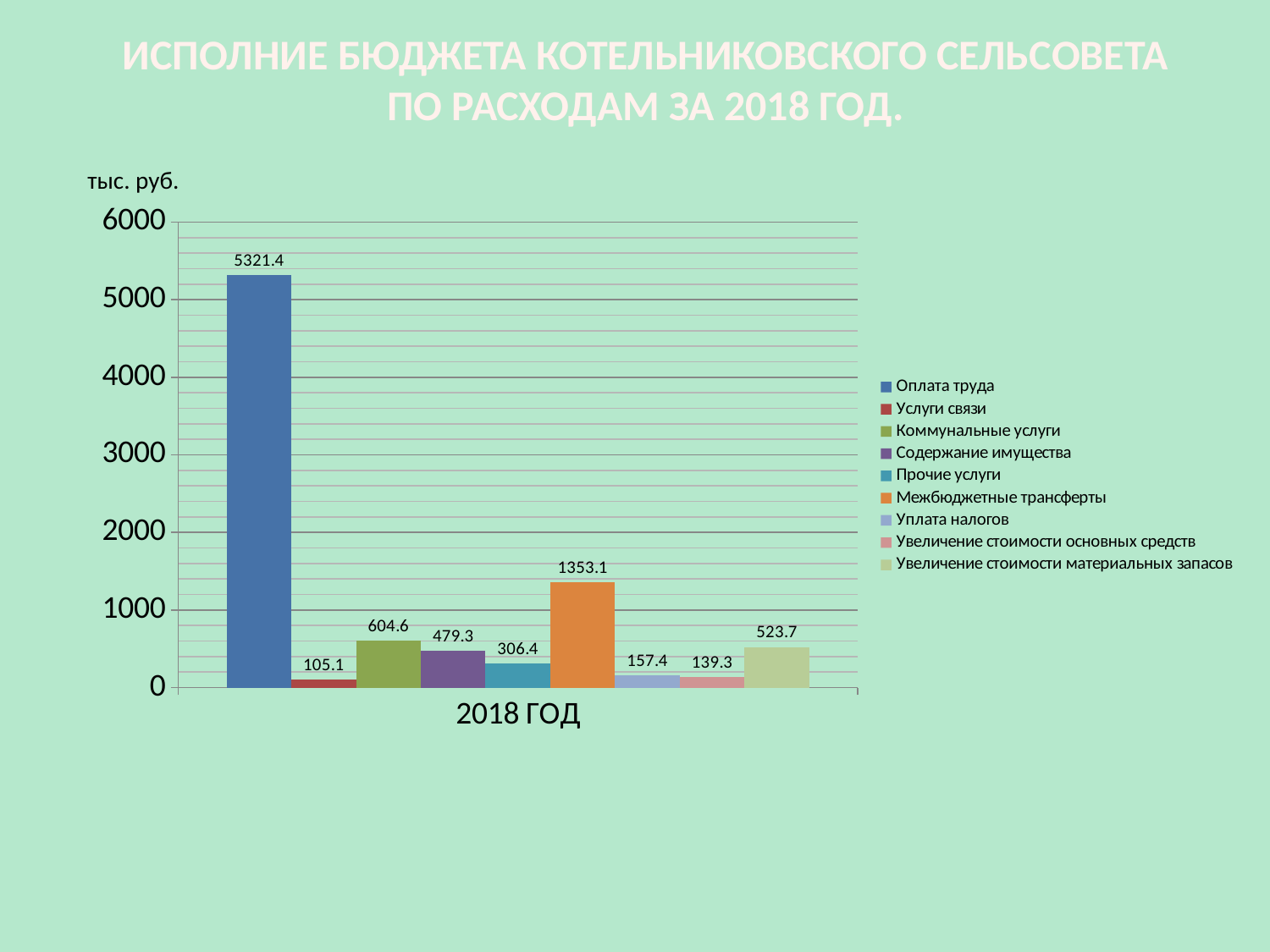
What is the difference between Коммунальные услуги and Содержание имущества? 125.3 How many series does the legend list? 9 Which series has the highest value? Оплата труда What is the value for Увеличение стоимости материальных запасов? 523.7 Which series has the lowest value? Услуги связи Is the value for Межбюджетные трансферты greater or less than 1000? greater What kind of chart is shown? bar chart What is the value for Межбюджетные трансферты? 1353.1 What is the label on the horizontal axis? 2018 ГОД What is the value for Оплата труда? 5321.4 What unit is shown above the vertical axis? тыс. руб. Which is larger, Уплата налогов or Увеличение стоимости основных средств? Уплата налогов